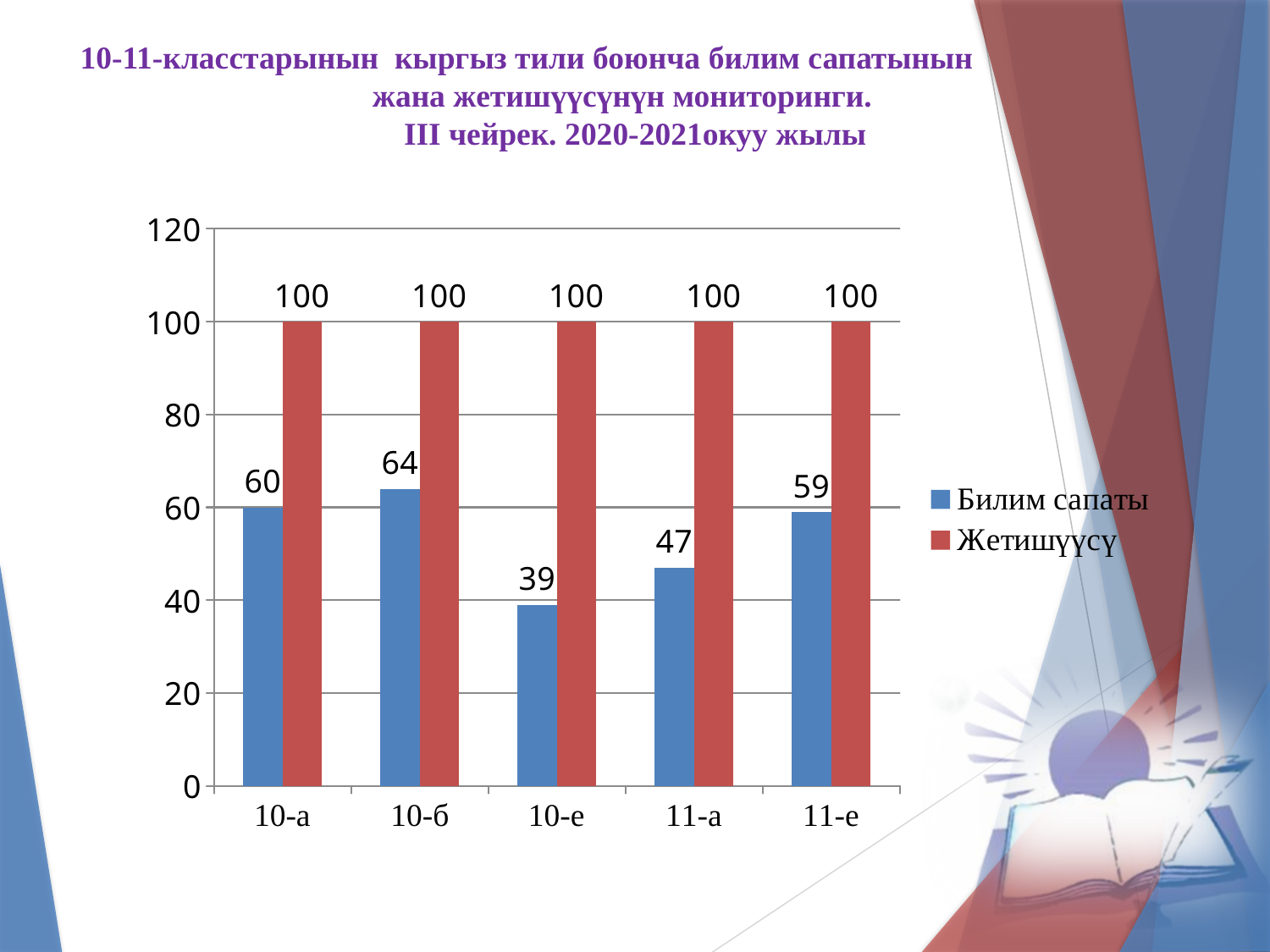
What is the value of Билим сапаты for 10-е? 39 How many series does the legend list? 2 Which is larger, the Билим сапаты value for 11-е or for 11-а? 11-е How many classes are shown on the x axis? 5 Which class has the highest Билим сапаты value? 10-б What is the value of Жетишүүсү for 11-а? 100 What is the value of Билим сапаты for 10-а? 60 Which colour represents Жетишүүсү in the legend? red What is the difference between the Билим сапаты values for 10-б and 11-а? 17 Is the Билим сапаты value for 10-е greater or less than 40? less Which class has the lowest Билим сапаты value? 10-е What kind of chart is shown on the slide? bar chart